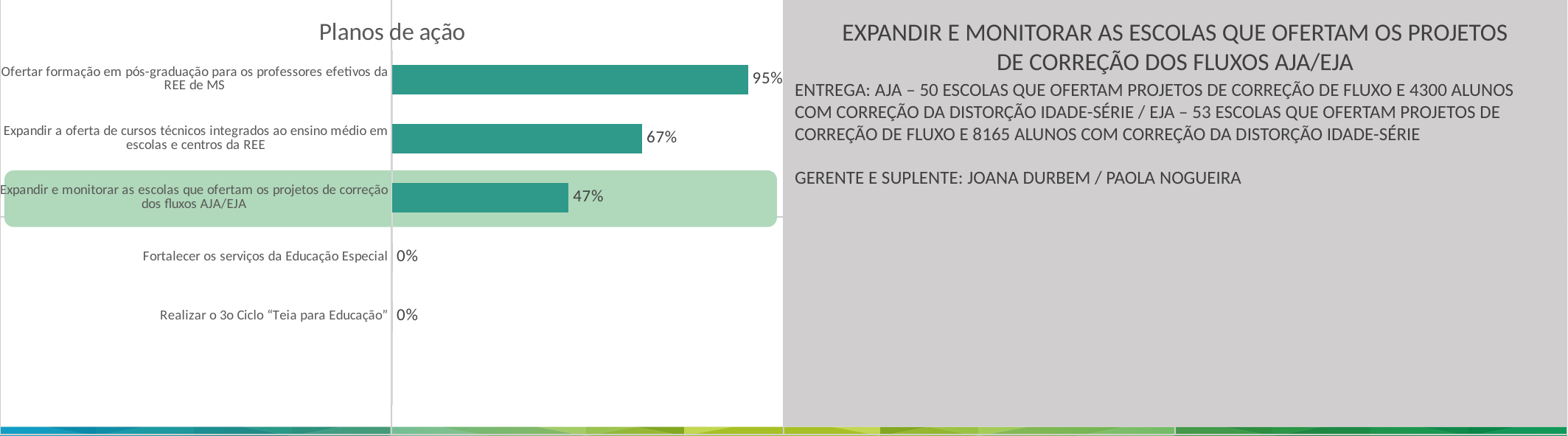
What is the value for 'Ofertar formação em pós-graduação para os professores efetivos da REE de MS'? 95% What is the difference between the values for 'Ofertar formação em pós-graduação para os professores efetivos da REE de MS' and 'Expandir a oferta de cursos técnicos integrados ao ensino médio em escolas e centros da REE'? 28% What is the value for 'Expandir a oferta de cursos técnicos integrados ao ensino médio em escolas e centros da REE'? 67% Which action plan has the highest value? Ofertar formação em pós-graduação para os professores efetivos da REE de MS What is the title of the chart? Planos de ação Which is larger: the value for 'Expandir e monitorar as escolas que ofertam os projetos de correção dos fluxos AJA/EJA' or for 'Expandir a oferta de cursos técnicos integrados ao ensino médio em escolas e centros da REE'? Expandir a oferta de cursos técnicos integrados ao ensino médio em escolas e centros da REE What is the value for 'Fortalecer os serviços da Educação Especial'? 0% How many action plans have a value of 0%? 2 How many action plans are shown in the chart? 5 What kind of chart is shown on the slide? Bar chart What is the value for 'Expandir e monitorar as escolas que ofertam os projetos de correção dos fluxos AJA/EJA'? 47% What is the difference between the values for 'Expandir a oferta de cursos técnicos integrados ao ensino médio em escolas e centros da REE' and 'Expandir e monitorar as escolas que ofertam os projetos de correção dos fluxos AJA/EJA'? 20%